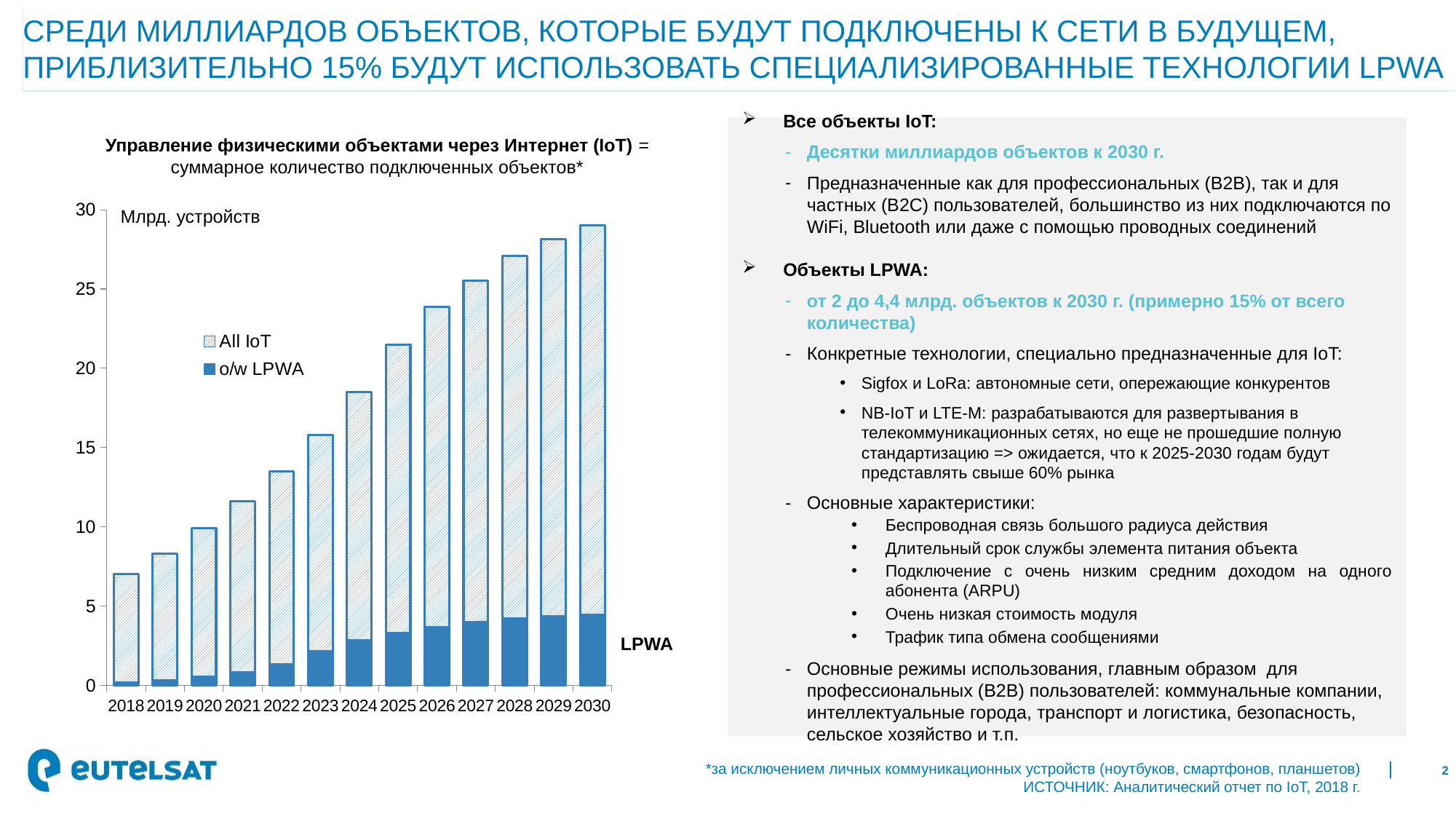
Do the All IoT values rise or fall from 2018 to 2030? rise Which year has the lowest All IoT value in the chart? 2018 How many years are shown along the x axis of the chart? 13 What kind of chart is shown on the slide? bar chart Is the o/w LPWA value for 2030 greater or less than 5? less Which year has the highest All IoT value in the chart? 2030 Is the All IoT value for 2030 greater or less than 25? greater What unit label is shown at the top of the chart's y axis? Млрд. устройств Is the All IoT value for 2022 greater or less than 15? less How many series does the chart legend list? 2 What are the two series named in the chart legend? All IoT and o/w LPWA